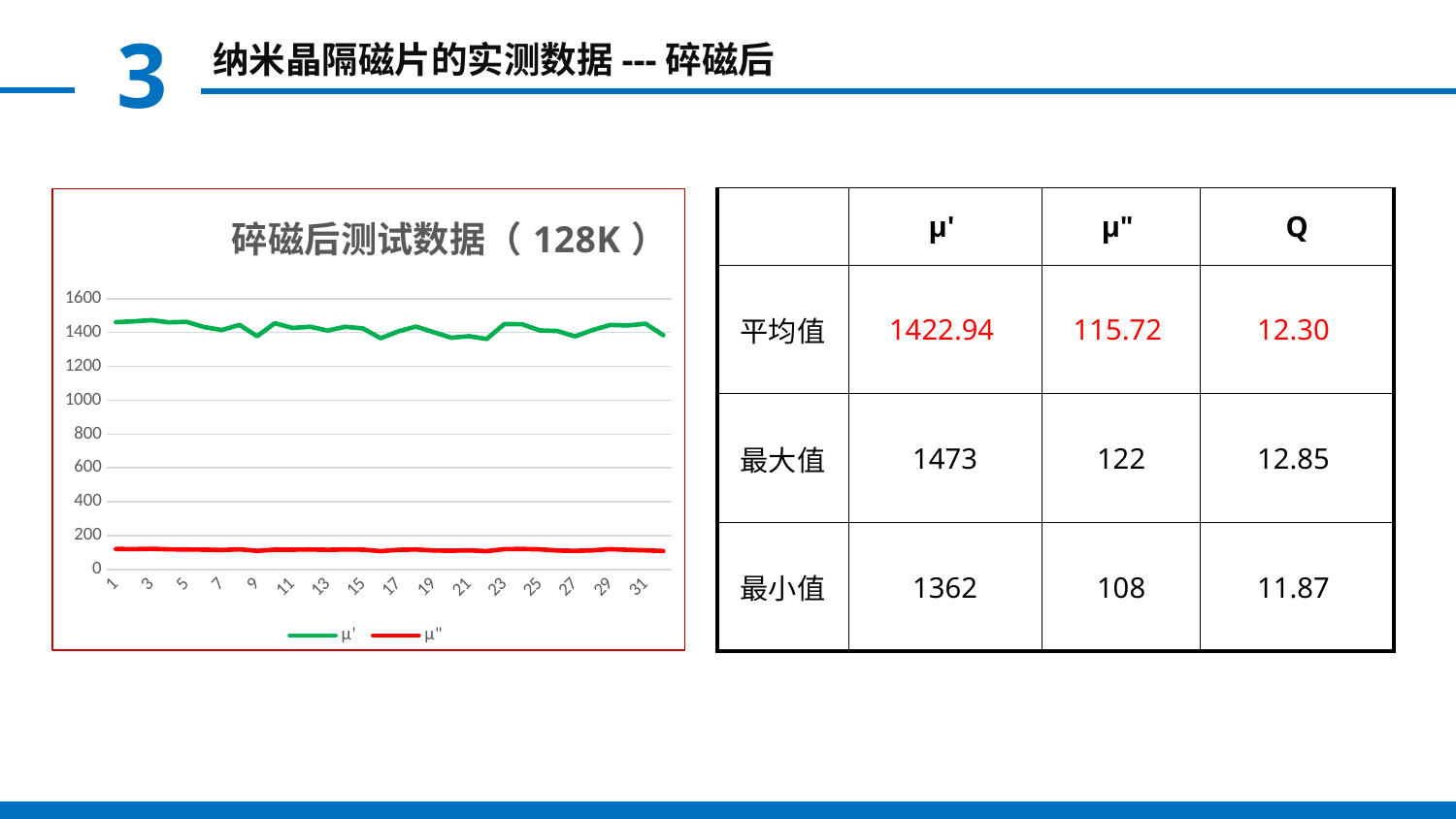
Is the value of μ' at point 1 greater or less than 1200? greater Which colour is used for the μ' series in the chart? green What is the title of the chart? 碎磁后测试数据（128K） Is the value of μ' at point 31 greater or less than 1600? less Is the value of μ" at point 1 greater or less than 200? less What kind of chart is shown on the slide? line chart How many series does the chart's legend list? 2 Which of the two series plotted in the chart has the higher values overall? μ' Which series has the larger value at point 15, μ' or μ"? μ'